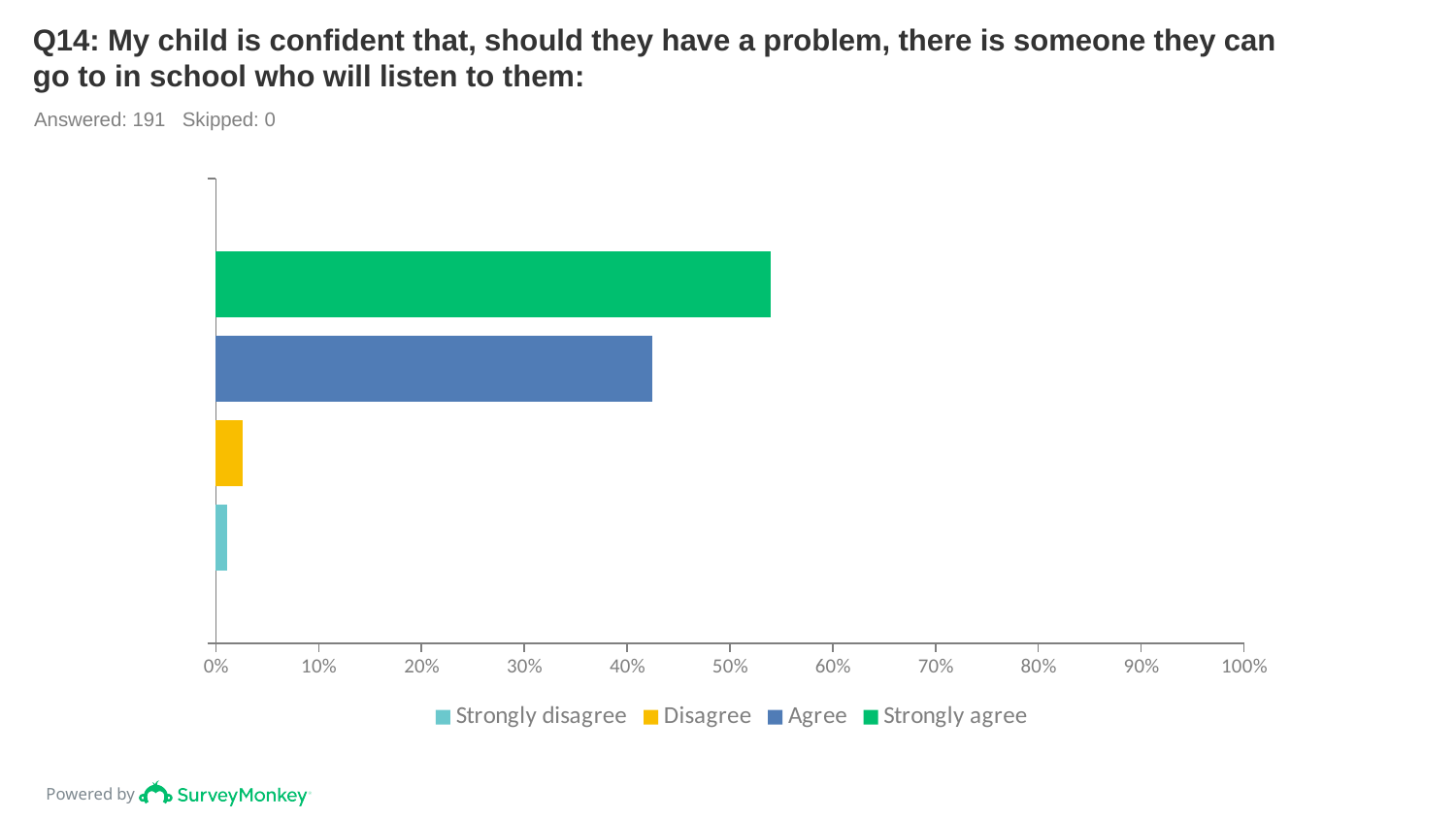
What kind of chart is shown on the slide? bar chart Which colour represents Strongly agree in the legend? green How many series does the legend list? 4 Which is larger, the value for Disagree or the value for Strongly disagree? Disagree Which is larger, the value for Agree or the value for Strongly agree? Strongly agree How many respondents answered this question? 191 Is the value for Disagree greater or less than 10%? less Which response has the highest value? Strongly agree Is the value for Strongly agree greater or less than 50%? greater Is the value for Agree greater or less than 50%? less Which response has the lowest value? Strongly disagree